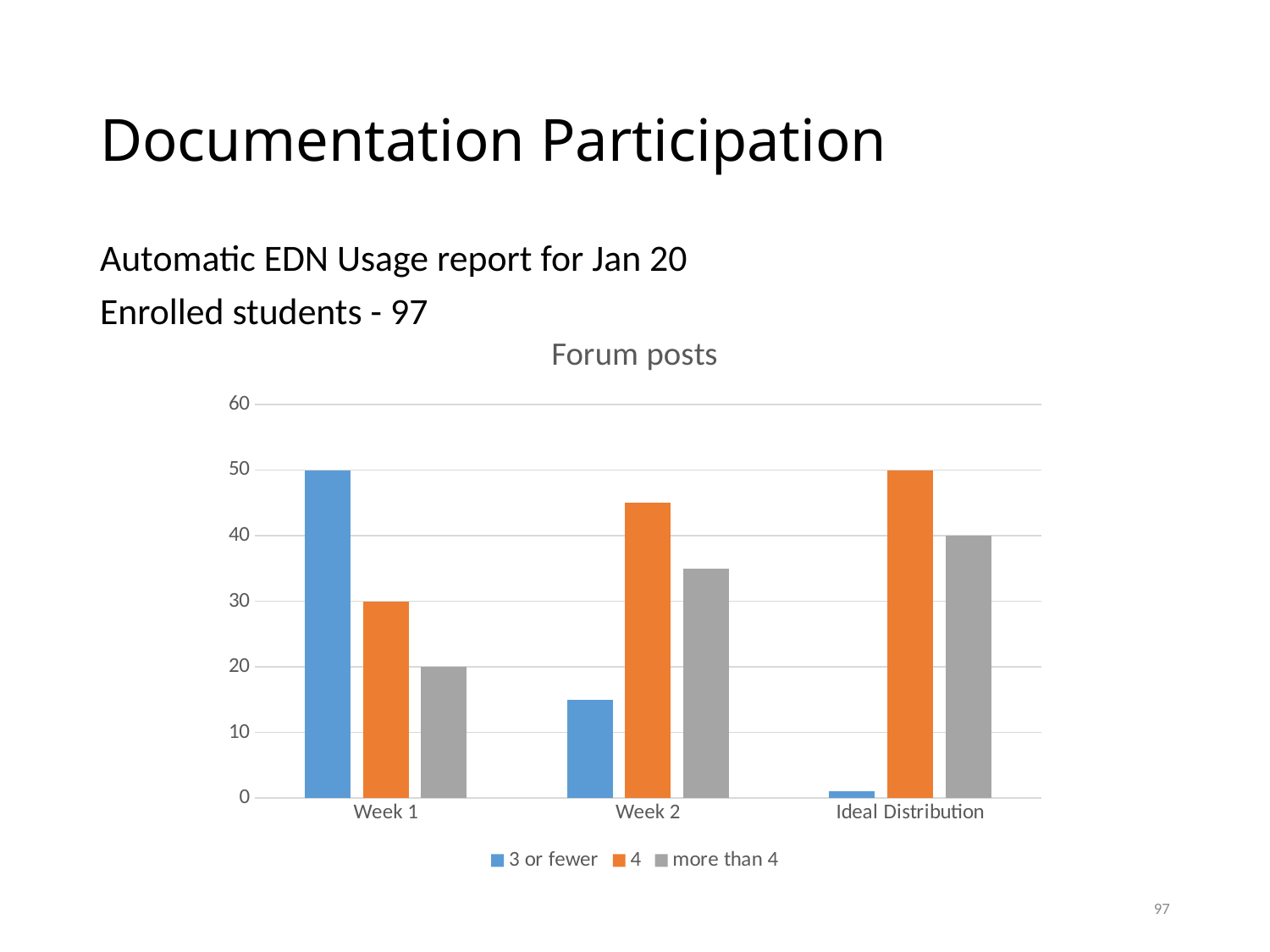
What is the value for '3 or fewer' in Week 1? 50 What is the value for 'more than 4' in Week 1? 20 Which series has the highest value in Week 1? 3 or fewer What is the title of the chart? Forum posts What is the value for '4' in Ideal Distribution? 50 How many series does the legend list? 3 Is the value for '4' in Week 2 greater or less than 40? greater What is the value for '4' in Week 1? 30 Is the value for '3 or fewer' in Week 2 greater or less than 20? less How many categories are shown on the x axis? 3 What is the value for 'more than 4' in Ideal Distribution? 40 What kind of chart is shown on the slide? bar chart